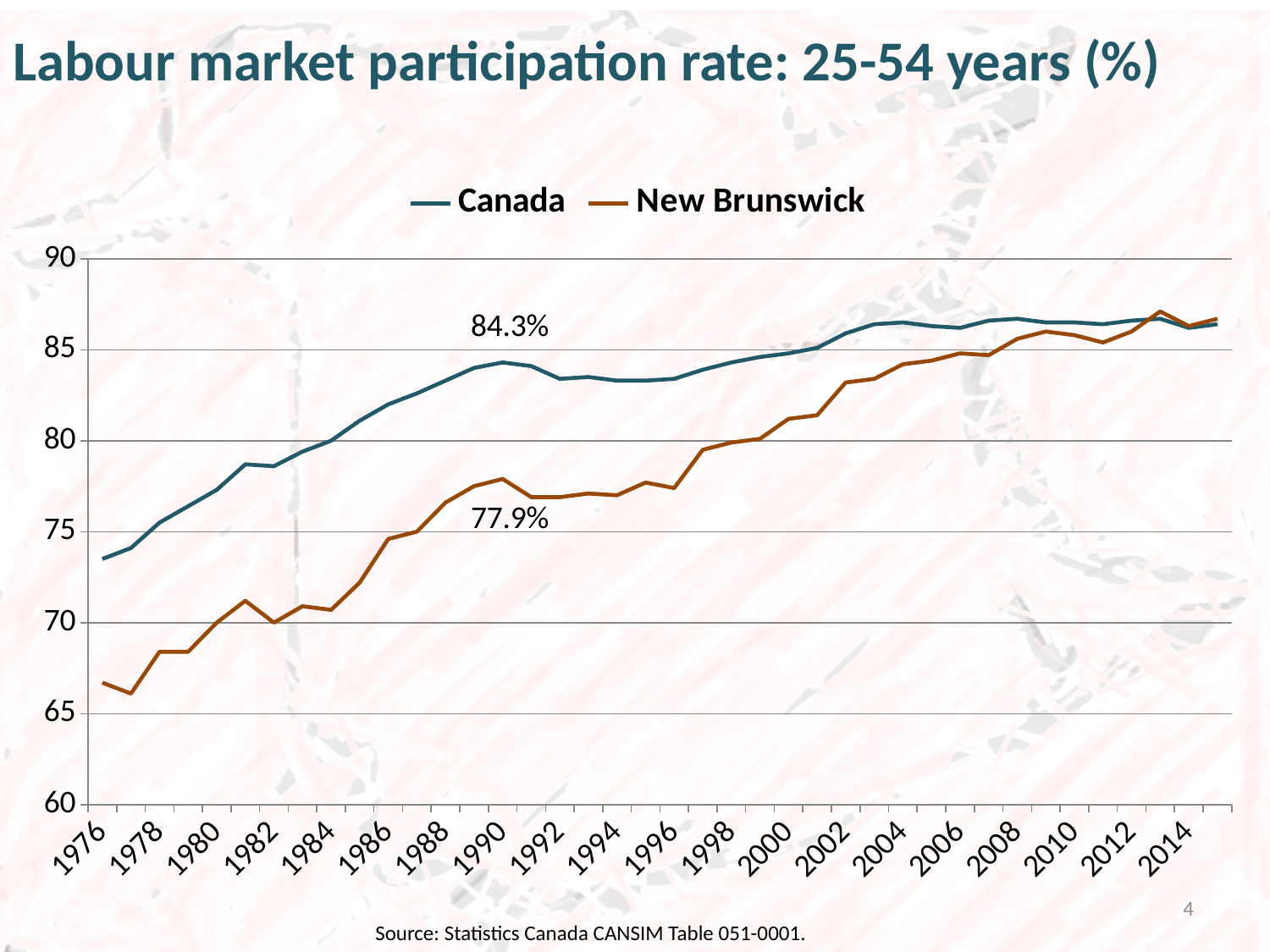
What is the labelled value on the New Brunswick line? 77.9% What kind of chart is shown on the slide? line chart Is the value for Canada in 1976 greater or less than 75? less Does the New Brunswick participation rate generally rise or fall from 1976 to 2014? rise In which year is the Canada participation rate at its lowest? 1976 Is the value for Canada in 2004 greater or less than 85? greater Is the value for New Brunswick in 1976 greater or less than 70? less What is the labelled value on the Canada line? 84.3% In 1976, which series has the higher participation rate, Canada or New Brunswick? Canada What is the difference between the labelled Canada value (84.3%) and the labelled New Brunswick value (77.9%)? 6.4 percentage points Which two series are shown in the legend? Canada and New Brunswick How many series does the legend list? 2